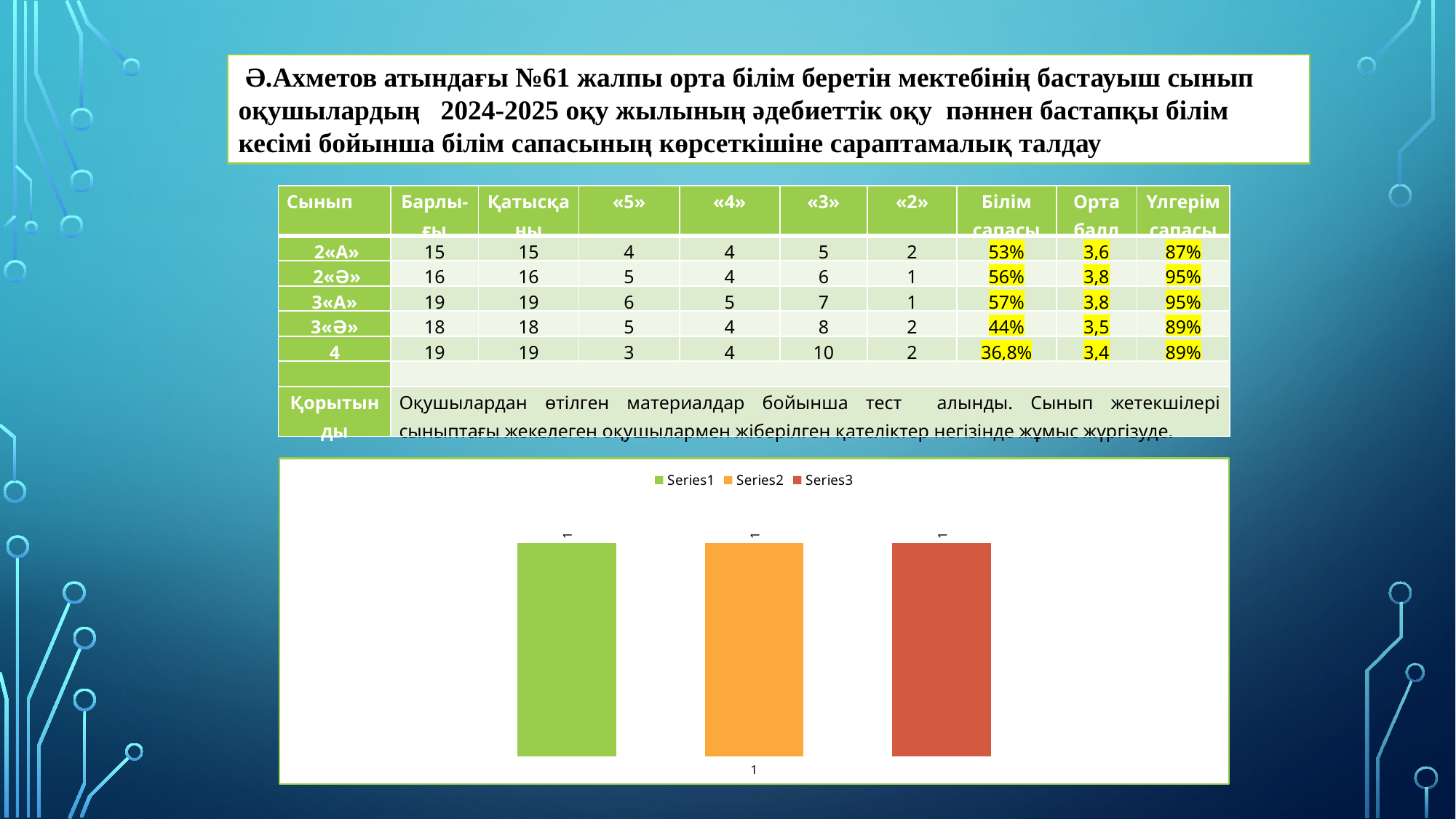
What colour is the Series2 bar in the chart? orange What is the label of the single category on the x axis of the chart? 1 What is the difference between the Series1 and Series3 values in the chart? 0 What is the value of the Series1 bar in the chart? 1 How many categories are plotted on the x axis of the chart? 1 What is the value of the Series2 bar in the chart? 1 How many series does the chart legend list? 3 What kind of chart is shown on the slide? bar chart What is the value of the Series3 bar in the chart? 1